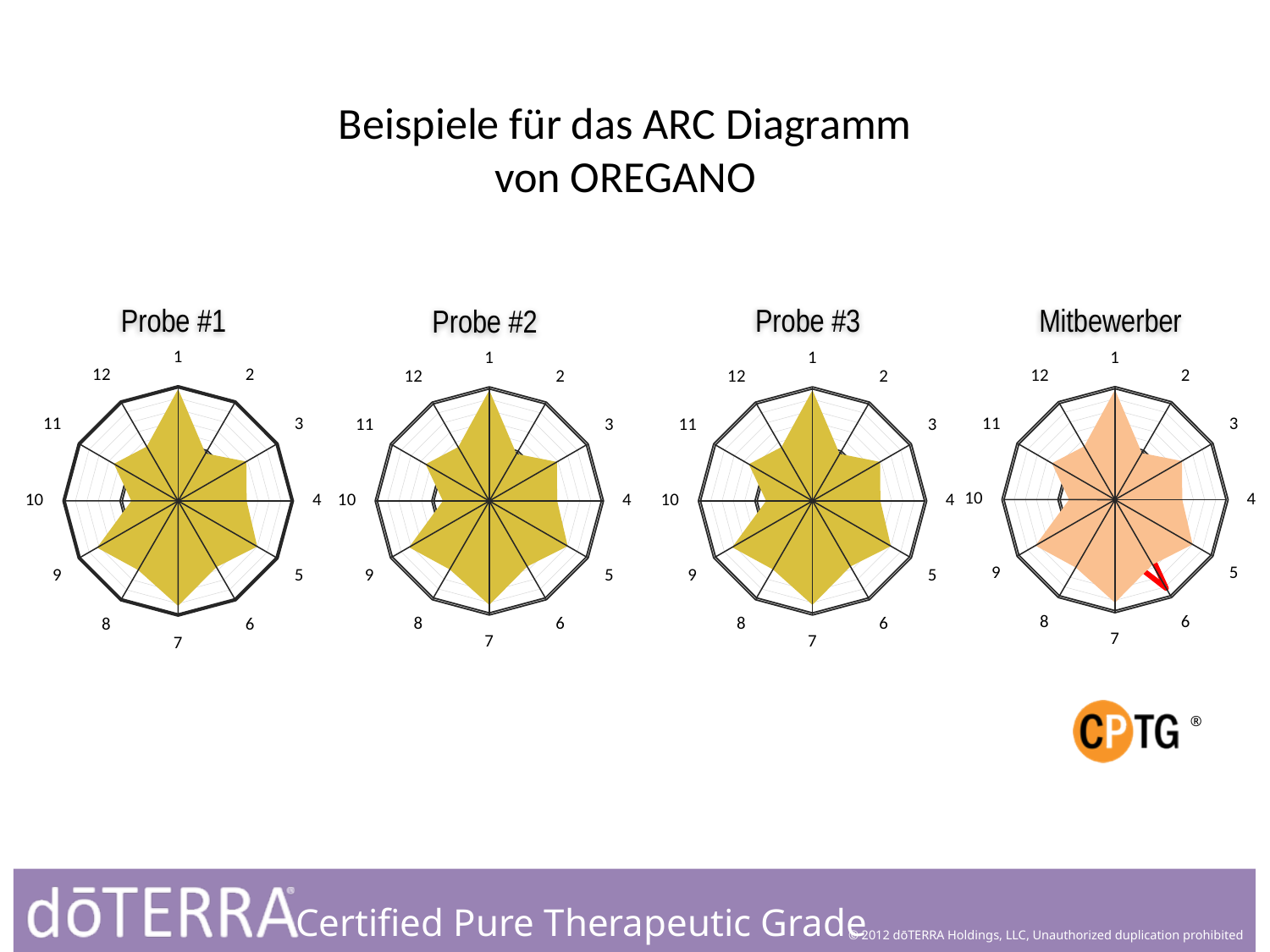
What is the title of the fourth (rightmost) chart? Mitbewerber In the Mitbewerber chart, which is larger, the value for category 6 or the value for category 10? Category 6 In the Probe #2 chart, which is larger, the value for category 1 or the value for category 10? Category 1 How many categories does the Probe #2 radar chart have? 12 In the Probe #3 chart, which is larger, the value for category 1 or the value for category 3? Category 1 What kind of chart is used for Probe #1? Radar chart In the Mitbewerber chart, which category does the red arrow point to? 6 How many categories does the Mitbewerber radar chart have? 12 Which chart uses an orange fill instead of yellow? Mitbewerber How many charts are shown on the slide? 4